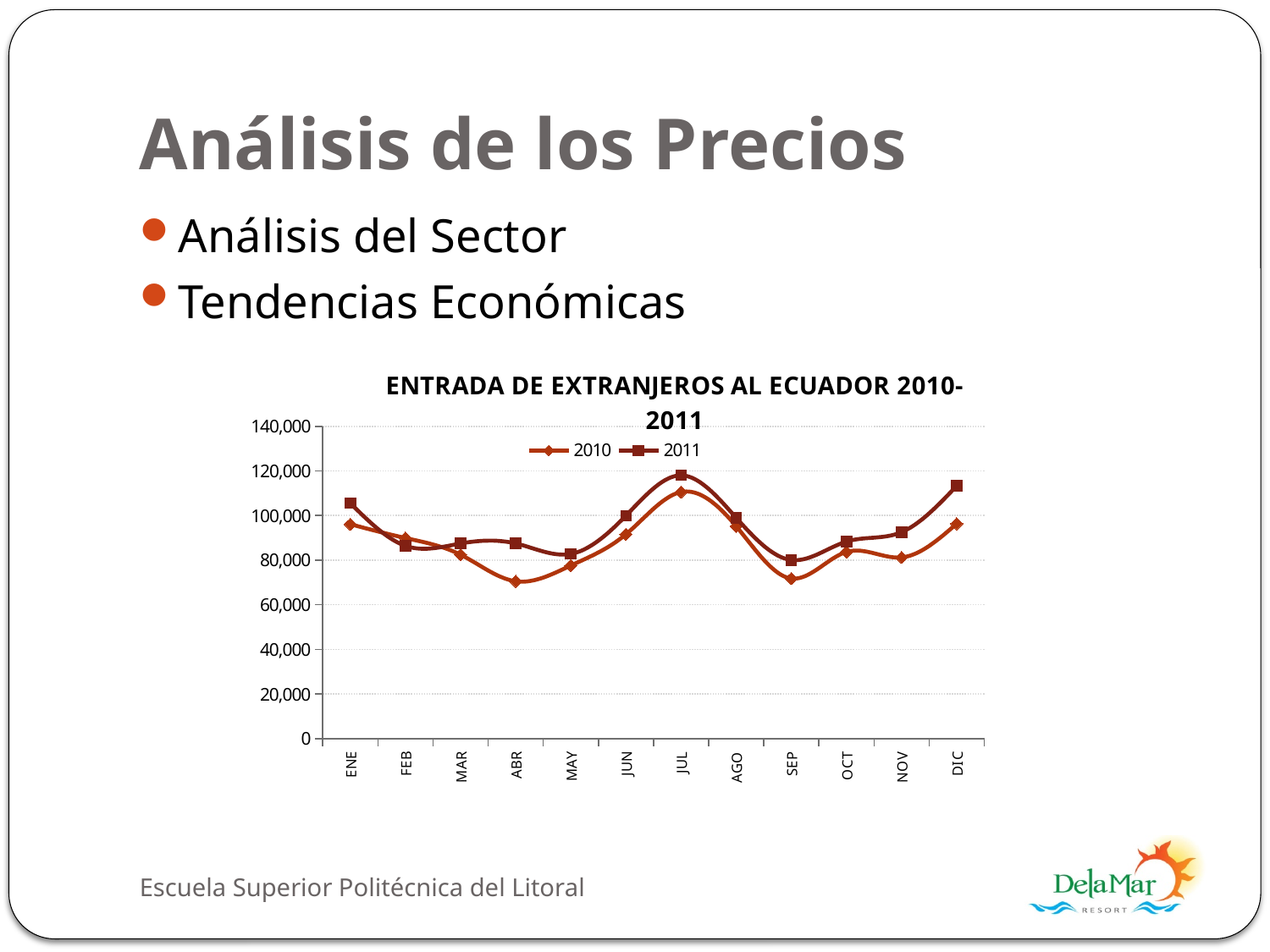
Is the value for 2011 in DIC greater or less than 100,000? greater How many months are plotted along the x axis? 12 How many series does the legend list? 2 Which series has the larger value in ENE, 2010 or 2011? 2011 Does the 2010 series rise or fall from ENE to ABR? fall In which month does the 2011 series reach its highest value? JUL Is the value for 2011 in JUL greater or less than 100,000? greater What is the title of the chart? ENTRADA DE EXTRANJEROS AL ECUADOR 2010-2011 Is the value for 2010 in ABR greater or less than 80,000? less Which series has the larger value in JUL, 2010 or 2011? 2011 In which month does the 2010 series reach its highest value? JUL What kind of chart is shown on the slide? line chart